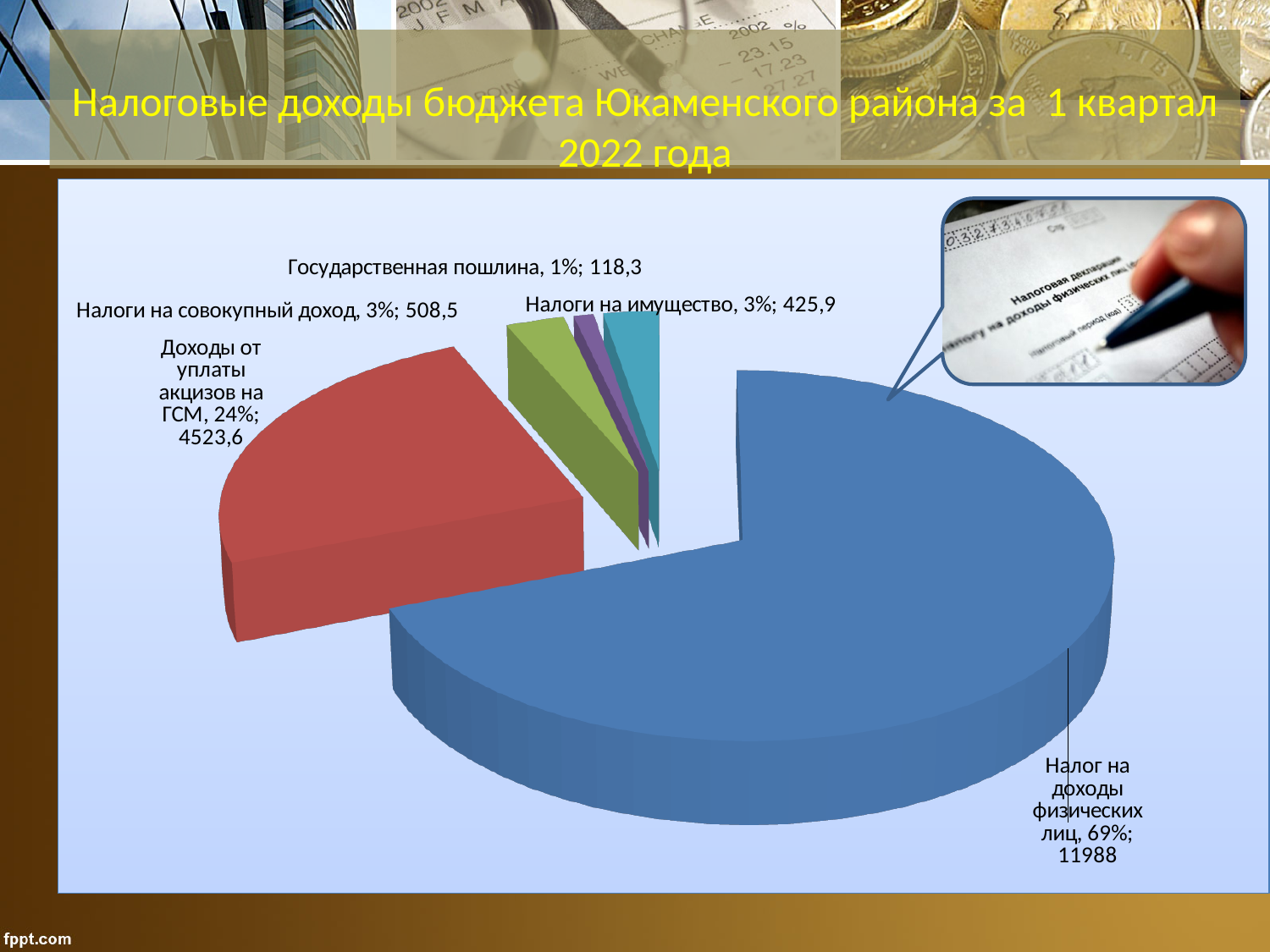
What type of chart is shown on the slide? Pie chart What is the value shown for Налоги на имущество? 425,9 What is the value shown for Государственная пошлина? 118,3 How many categories are shown in the pie chart? 5 What share of the pie does Налог на доходы физических лиц represent? 69% Which category has the largest slice of the pie? Налог на доходы физических лиц Which is larger, the value for Налоги на совокупный доход or the value for Налоги на имущество? Налоги на совокупный доход Which category has the smallest slice of the pie? Государственная пошлина What is the difference between the values for Налог на доходы физических лиц and Доходы от уплаты акцизов на ГСМ? 7464,4 What is the value shown for Доходы от уплаты акцизов на ГСМ? 4523,6 What is the value shown for Налог на доходы физических лиц? 11988 What share of the pie does Доходы от уплаты акцизов на ГСМ represent? 24%